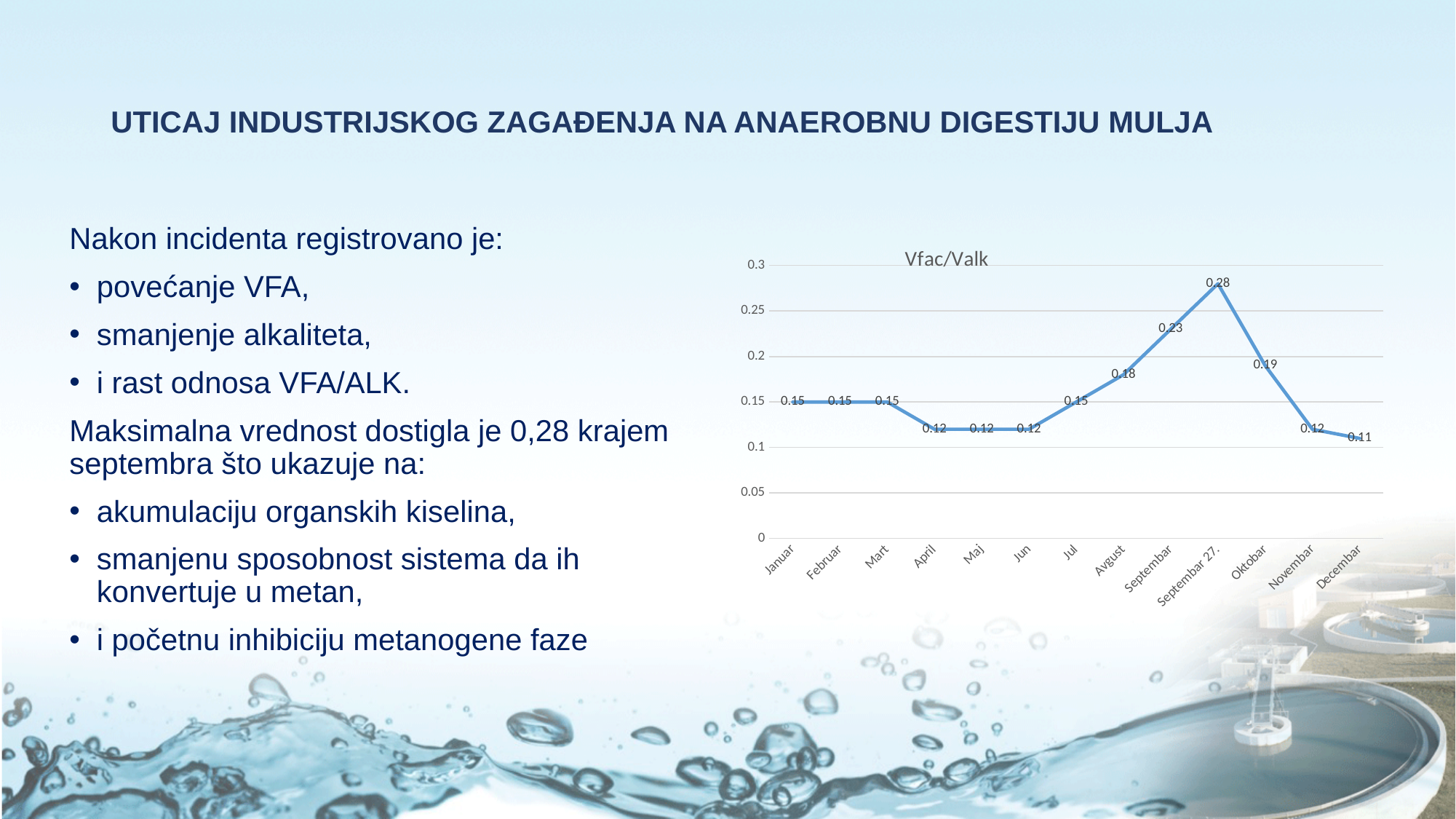
What is the value for Septembar 27. in the Vfac/Valk chart? 0.28 Which category has the lowest value in the Vfac/Valk chart? Decembar Is the value for Septembar in the Vfac/Valk chart greater or less than 0.2? greater What is the value for April in the Vfac/Valk chart? 0.12 Which is larger in the Vfac/Valk chart, the value for Oktobar or the value for Avgust? Oktobar What is the value for Avgust in the Vfac/Valk chart? 0.18 Does the value in the Vfac/Valk chart rise or fall from Septembar 27. to Decembar? fall What is the difference between the values for Septembar 27. and Septembar in the Vfac/Valk chart? 0.05 Which category has the highest value in the Vfac/Valk chart? Septembar 27. What is the value for Decembar in the Vfac/Valk chart? 0.11 How many data points are plotted in the Vfac/Valk chart? 13 What kind of chart is the Vfac/Valk chart? line chart